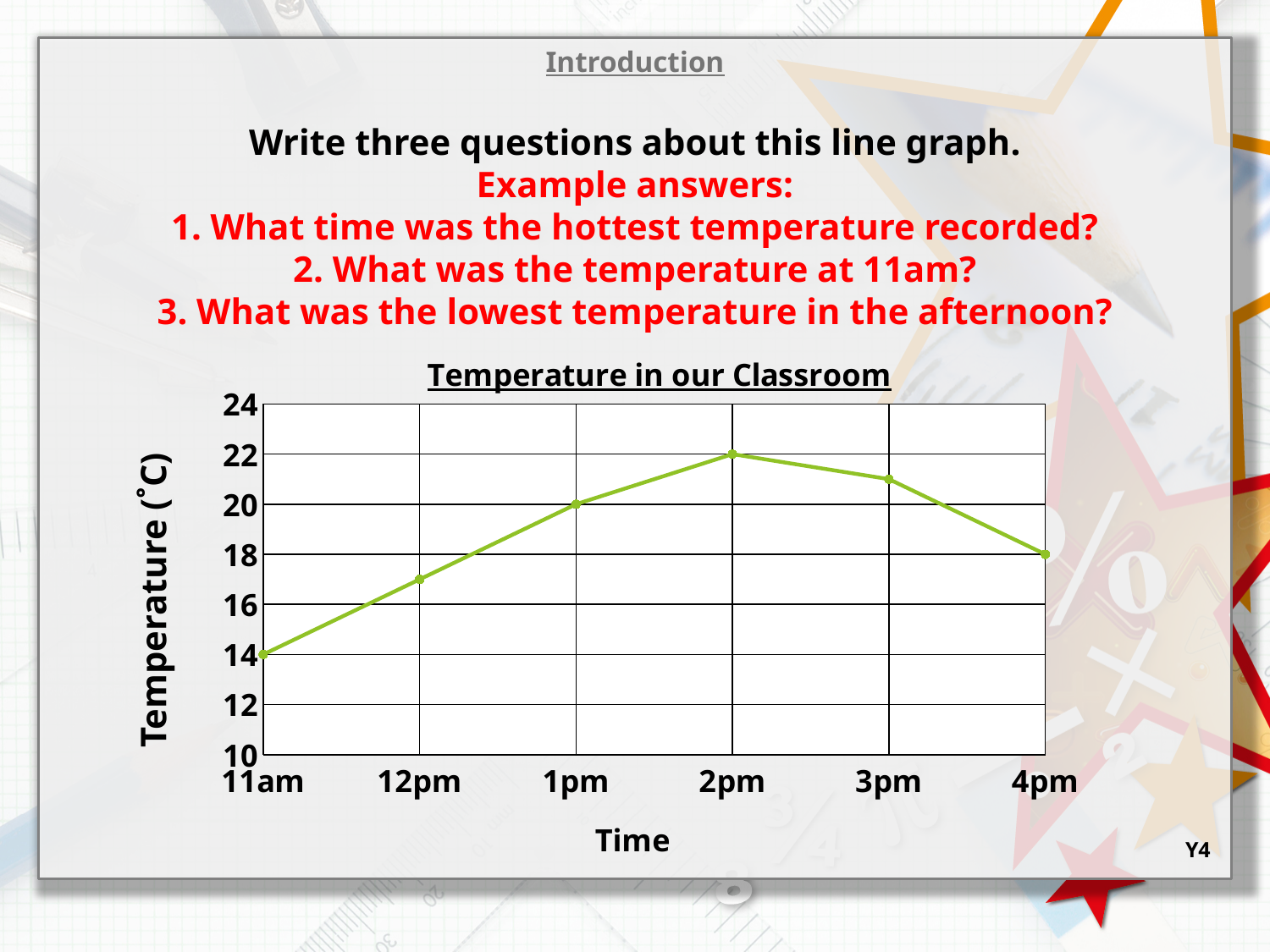
How many time points are plotted on the chart? 6 At which time is the temperature lowest? 11am What kind of chart is shown on the slide? line chart Which is higher, the temperature at 1pm or the temperature at 4pm? 1pm What is the difference between the temperature at 2pm and the temperature at 11am? 8 At which time is the temperature highest? 2pm What is the temperature at 4pm? 18 Is the temperature at 3pm greater or less than 22? less What is the temperature at 11am? 14 What is the temperature at 2pm? 22 What is the temperature at 1pm? 20 Is the temperature at 12pm greater or less than 16? greater